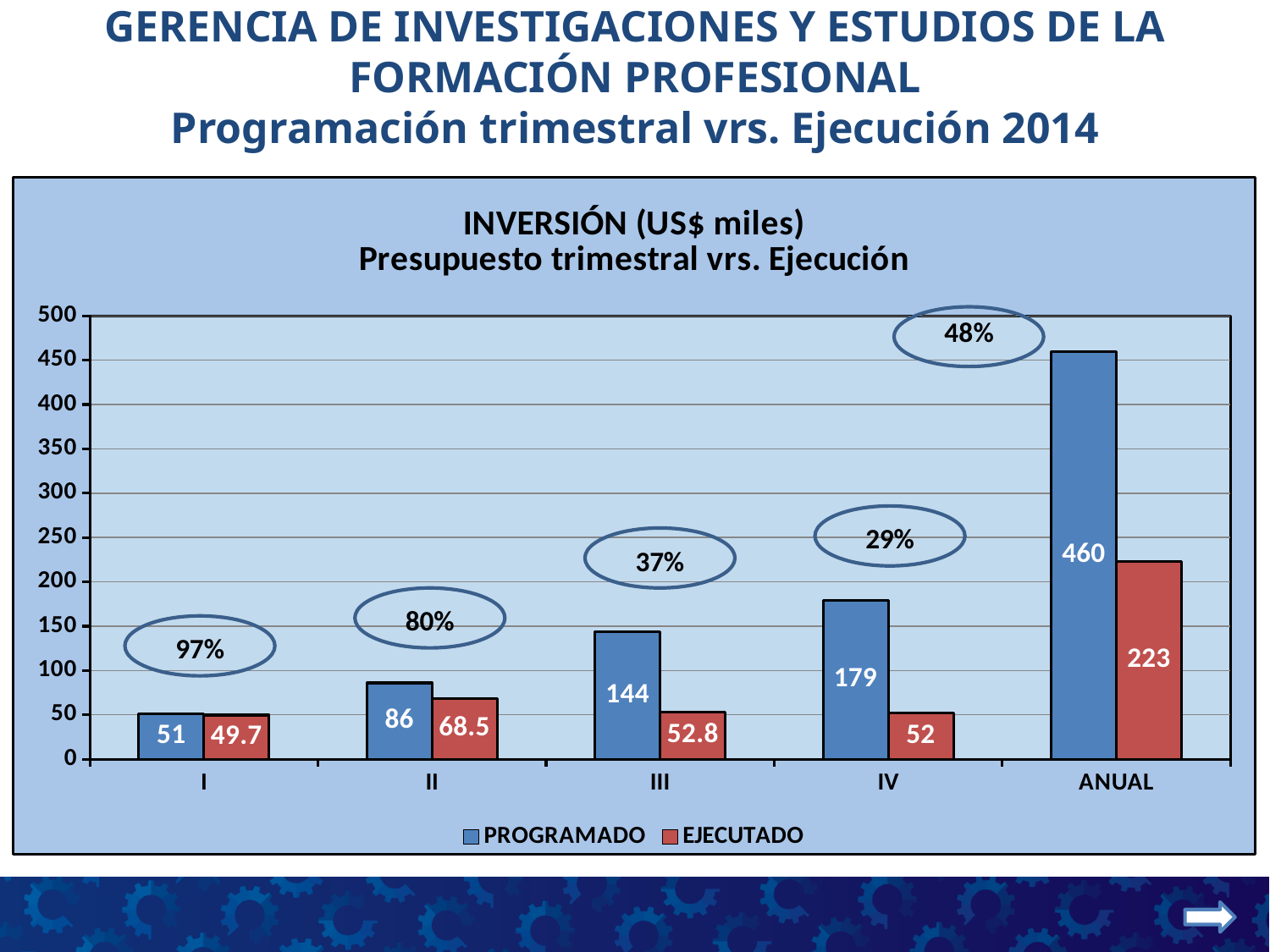
What is the PROGRAMADO value for quarter III? 144 What is the difference between the PROGRAMADO and EJECUTADO values for quarter IV? 127 Which is larger for quarter II: PROGRAMADO or EJECUTADO? PROGRAMADO Which category has the highest PROGRAMADO value? ANUAL What is the EJECUTADO value for ANUAL? 223 Which category has the lowest EJECUTADO value? I How many series does the legend list? 2 How many categories are shown on the x axis? 5 Is the PROGRAMADO value for ANUAL greater or less than 400? greater What kind of chart is shown? bar chart What percentage is shown in the circle above quarter III? 37% What is the EJECUTADO value for quarter II? 68.5